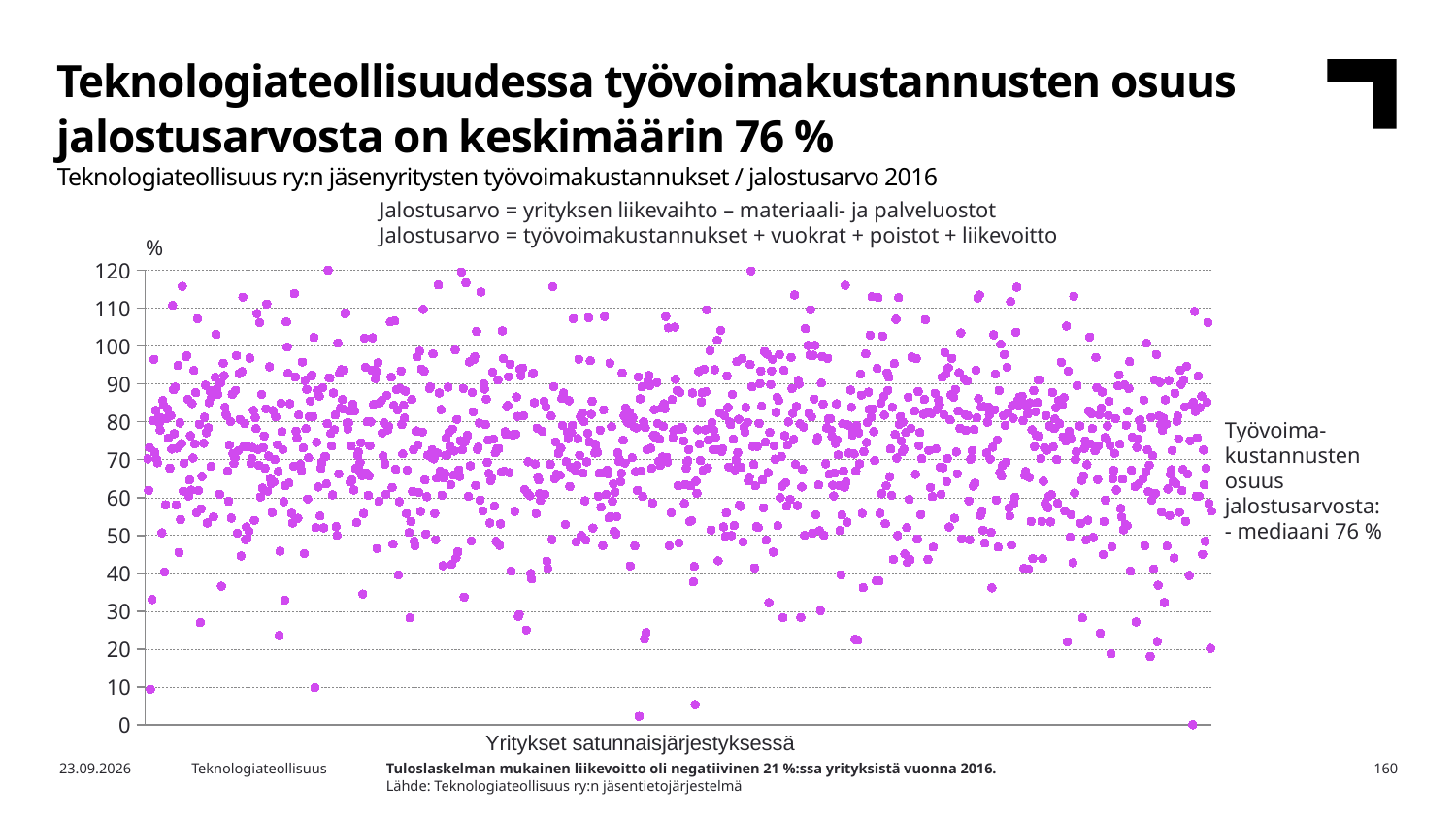
What kind of chart is shown on the slide? Scatter chart What is the label of the x axis of the chart? Yritykset satunnaisjärjestyksessä Do the plotted values show a clear rising or falling trend along the x axis? No clear trend Is the median value stated on the chart greater or less than 70? greater What unit is shown on the y axis of the chart? % What is the median share of labour costs in value added stated on the chart? 76 % Is the median value stated on the chart greater or less than 80? less